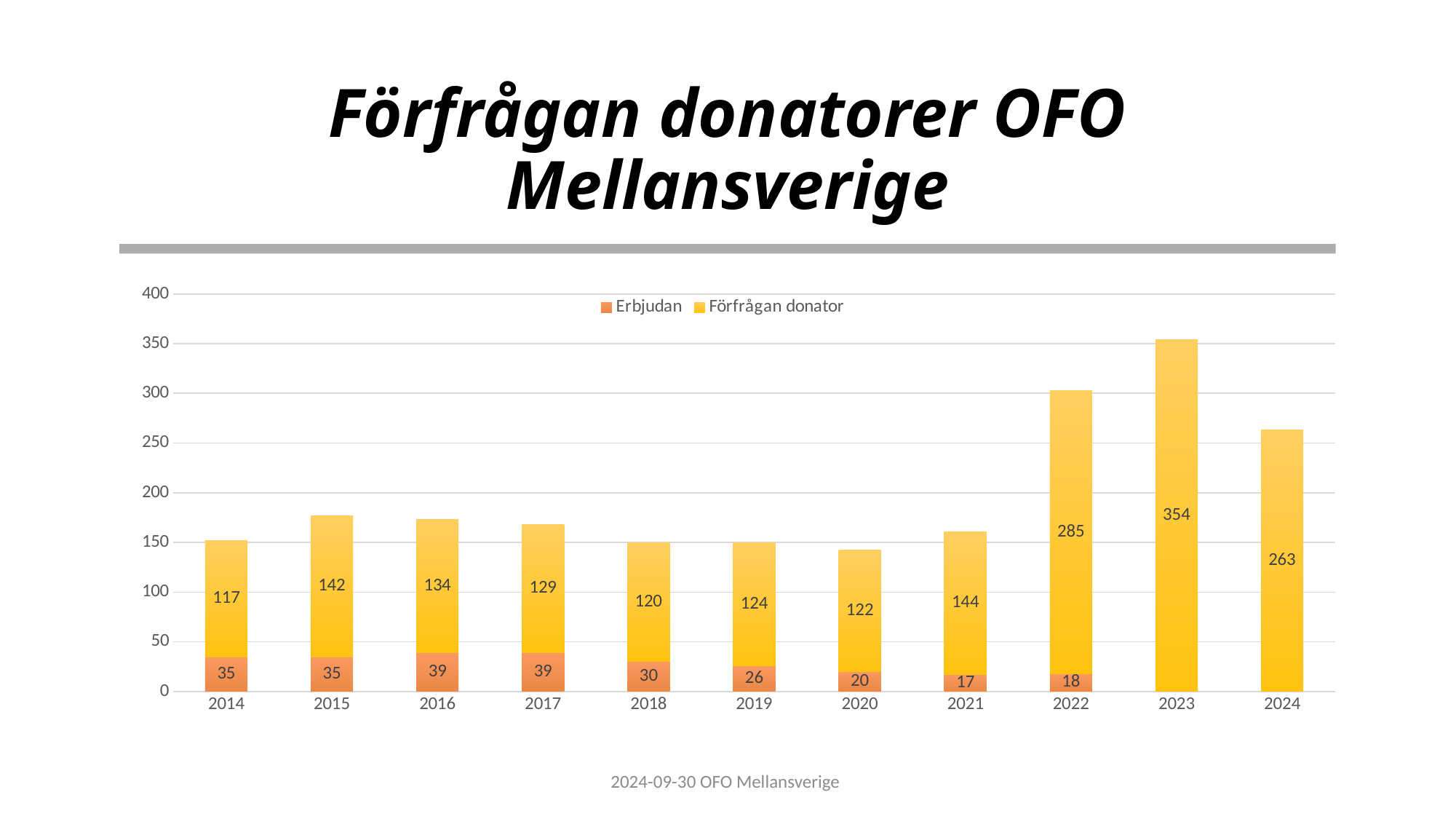
What is the total of the stacked bar for 2022? 303 How many years are shown on the x axis? 11 What is the title of the slide? Förfrågan donatorer OFO Mellansverige What is the difference between the Förfrågan donator values for 2023 and 2024? 91 Which year has the lowest Erbjudan value among the years where it is shown? 2021 Is the total of the stacked bar for 2021 greater or less than 150? greater Which year has the highest Förfrågan donator value? 2023 Which is larger, the Förfrågan donator value for 2015 or for 2017? 2015 How many series does the legend list? 2 What type of chart is shown on the slide? stacked bar chart What is the Erbjudan value for 2016? 39 What is the Förfrågan donator value for 2022? 285